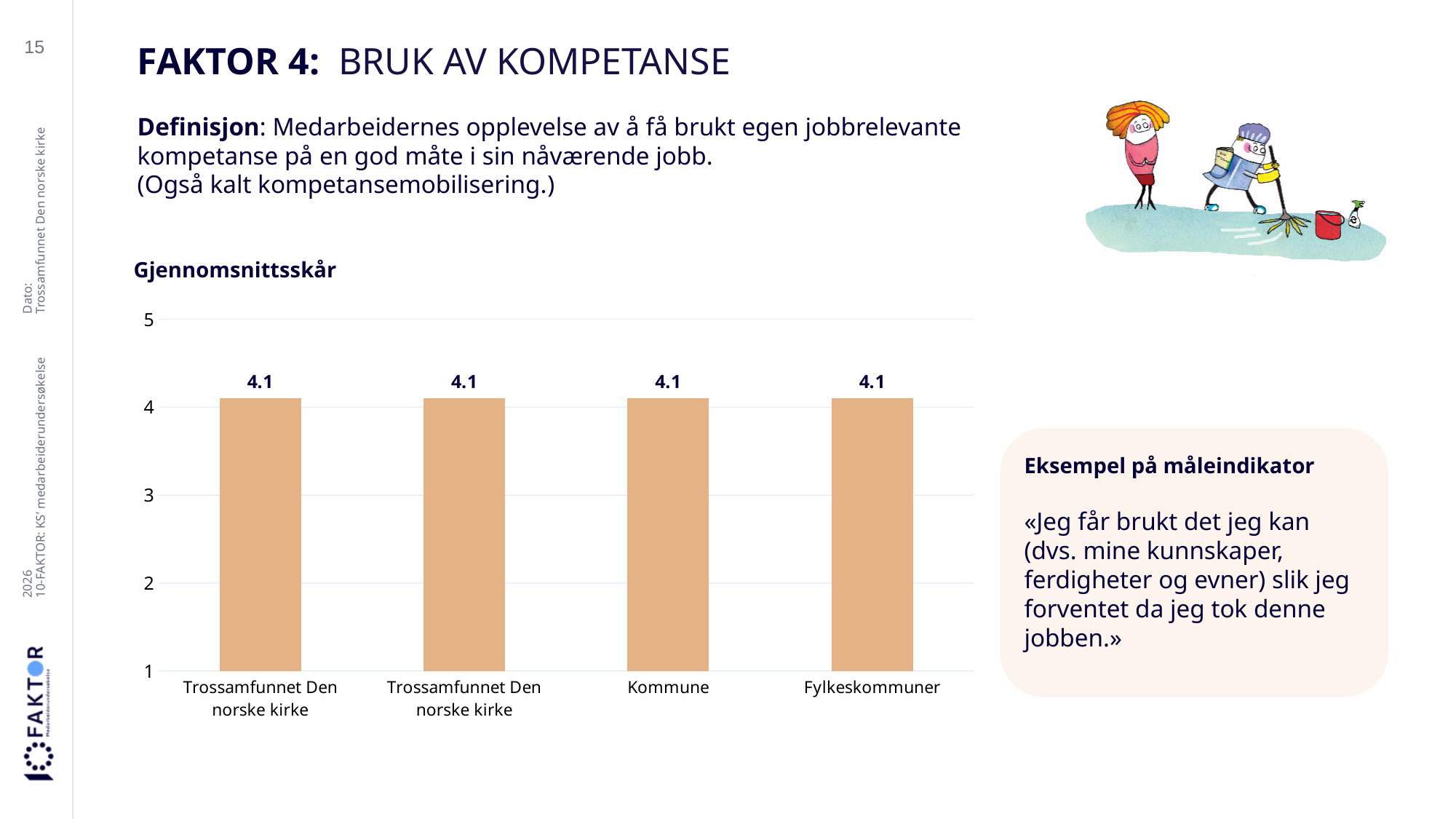
Is the value for Kommune larger than, smaller than, or equal to the value for Fylkeskommuner? equal Is the value for Fylkeskommuner greater or less than 3? greater What is the value for Kommune in the Gjennomsnittsskår chart? 4.1 How many bars are shown in the chart? 4 Is the value for Kommune greater or less than 5? less What kind of chart is shown on the slide? bar chart Do the values rise, fall, or stay the same across the bars from left to right? stay the same What is the value for Fylkeskommuner in the Gjennomsnittsskår chart? 4.1 What is the highest value shown on the chart's vertical axis? 5 What is the value of the first (leftmost) bar, labelled Trossamfunnet Den norske kirke? 4.1 What is the difference between the values for Kommune and Fylkeskommuner? 0 What is the title of the chart? Gjennomsnittsskår